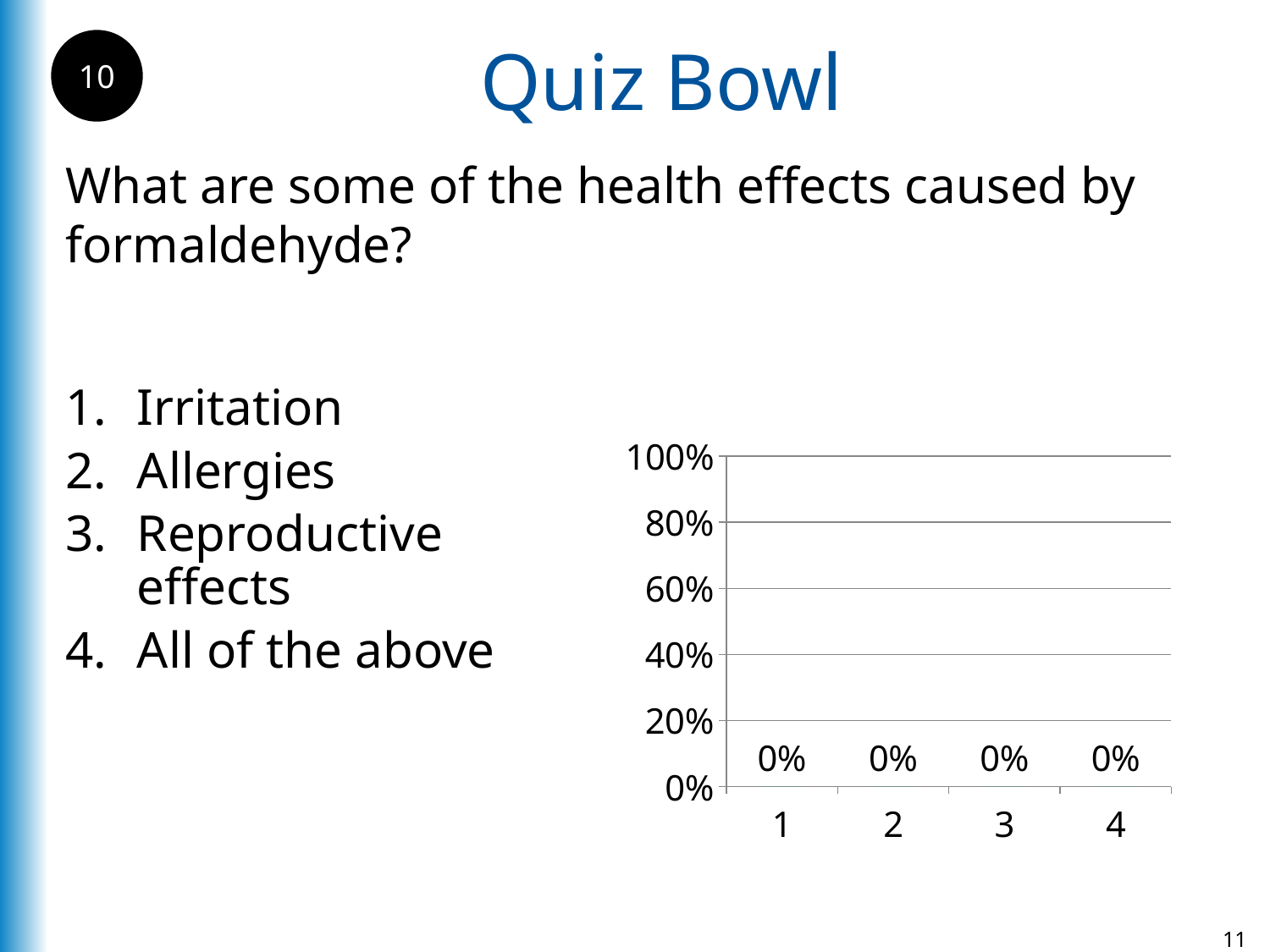
What is the value shown for category 4 in the chart? 0% What is the highest tick label on the y axis of the chart? 100% Do the values change from category 1 to category 4, or stay the same? stay the same What is the difference between the values for category 1 and category 4? 0% How many categories are shown on the x axis of the chart? 4 What kind of chart is shown on the slide? bar chart What is the value shown for category 3 in the chart? 0% Is the value for category 3 greater or less than 20%? less What is the value shown for category 1 in the chart? 0% What is the value shown for category 2 in the chart? 0%